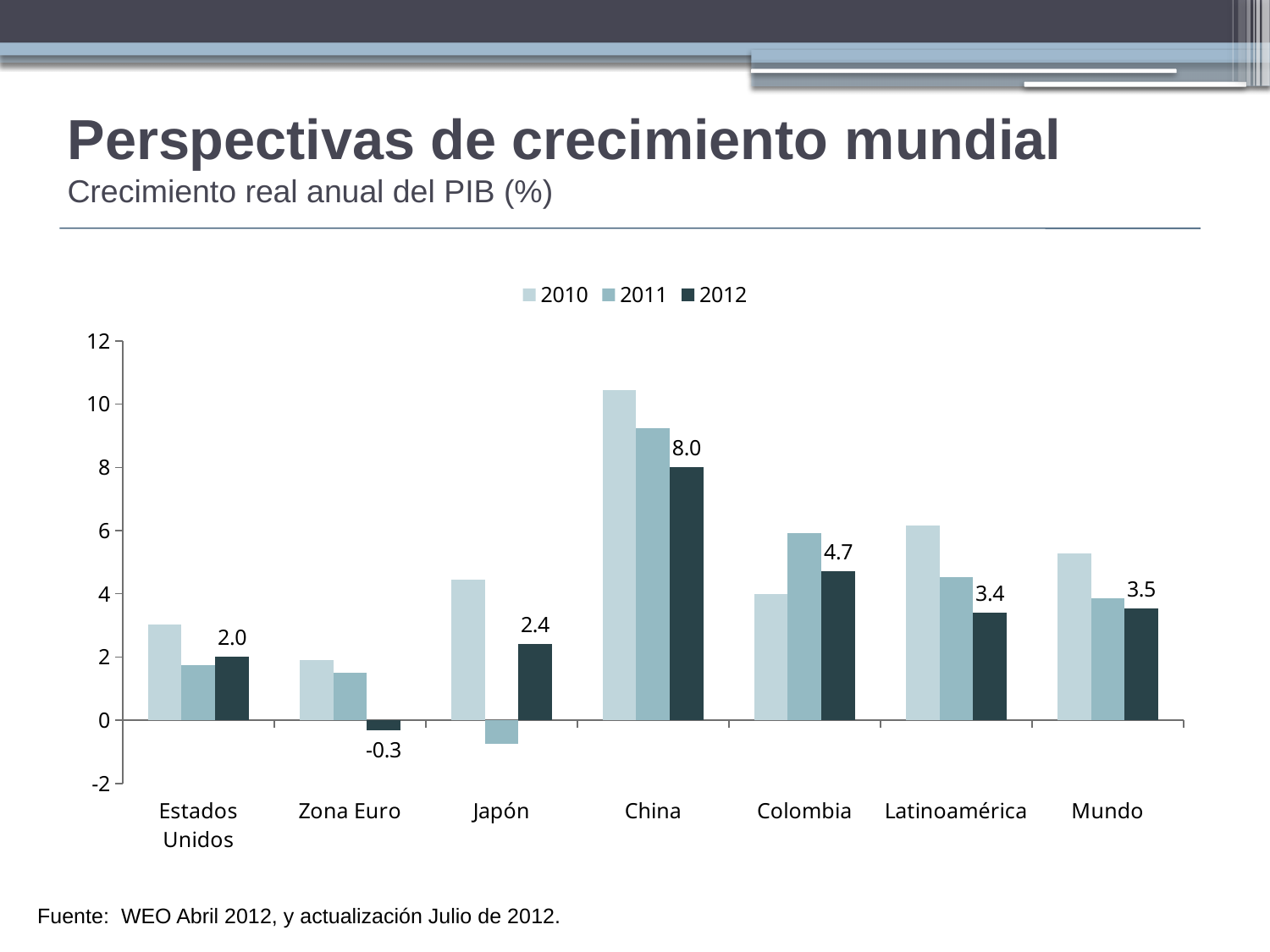
Which is larger, the 2012 value for Latinoamérica or the 2012 value for Mundo? Mundo Which category has the highest 2012 value? China Which category has the lowest 2012 value? Zona Euro Is the 2011 value for Japón greater or less than 0? less What kind of chart is shown on the slide? bar chart Is the 2010 value for China greater or less than 10? greater How many series does the legend list? 3 What is the 2012 value for Zona Euro? -0.3 What is the 2012 value for China? 8.0 How many categories are shown on the x axis? 7 What is the difference between the 2012 values for China and Colombia? 3.3 What is the 2012 value for Colombia? 4.7